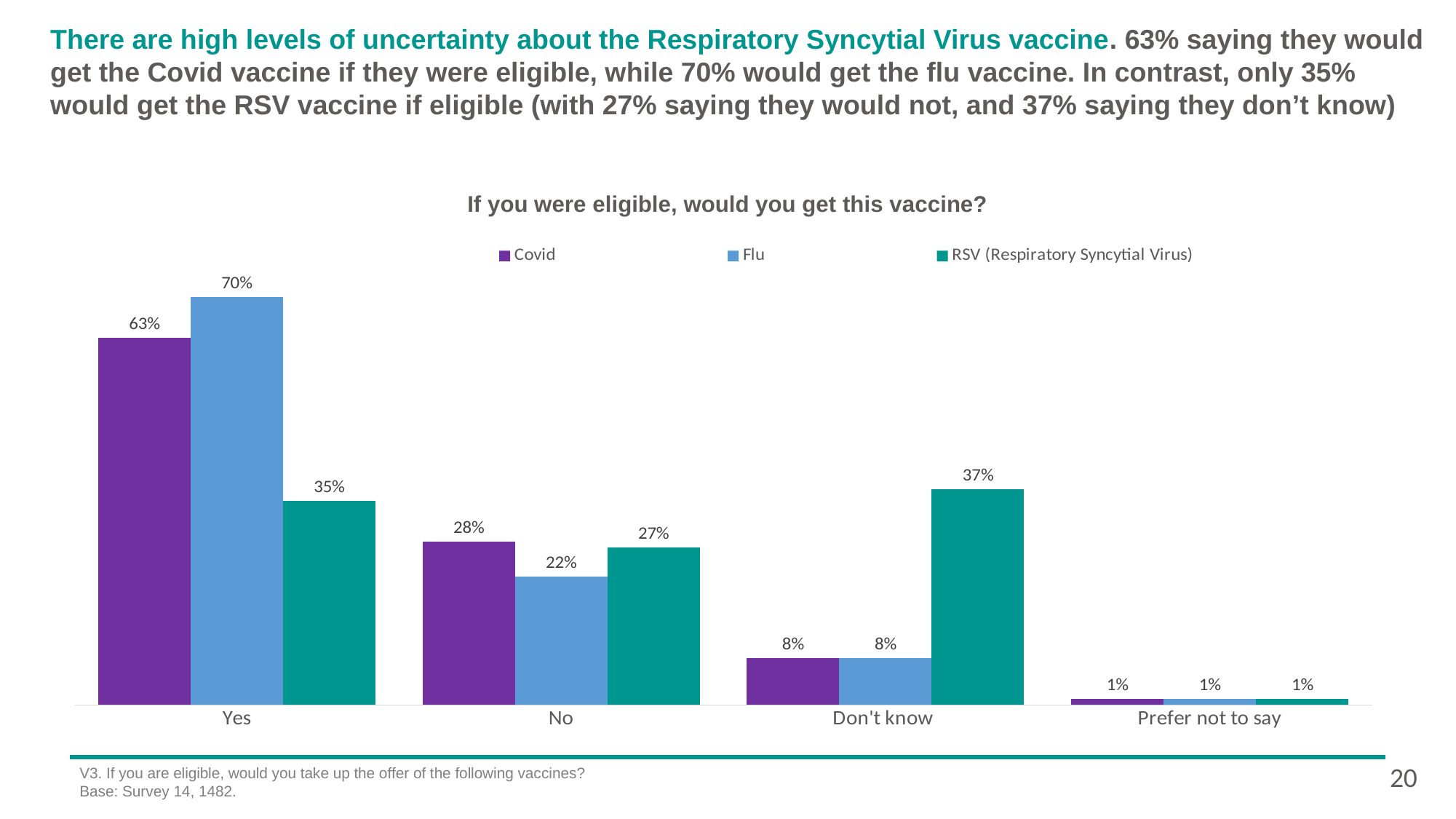
Which vaccine has the lowest value in the 'Yes' category? RSV (Respiratory Syncytial Virus) In the 'No' category, which is larger: the Covid value or the Flu value? Covid What is the value for RSV (Respiratory Syncytial Virus) in the 'Don't know' category? 37% What kind of chart is shown on the slide? Bar chart What is the title of the chart? If you were eligible, would you get this vaccine? What is the difference between the Flu and Covid values in the 'Yes' category? 7% How many response categories are shown on the x axis? 4 Which vaccine has the highest value in the 'Yes' category? Flu How many series does the legend list? 3 What percentage of respondents said they would get the Flu vaccine if eligible (the 'Yes' category)? 70% What is the difference between the RSV and Flu values in the 'Don't know' category? 29% What is the value for Covid in the 'No' category? 28%